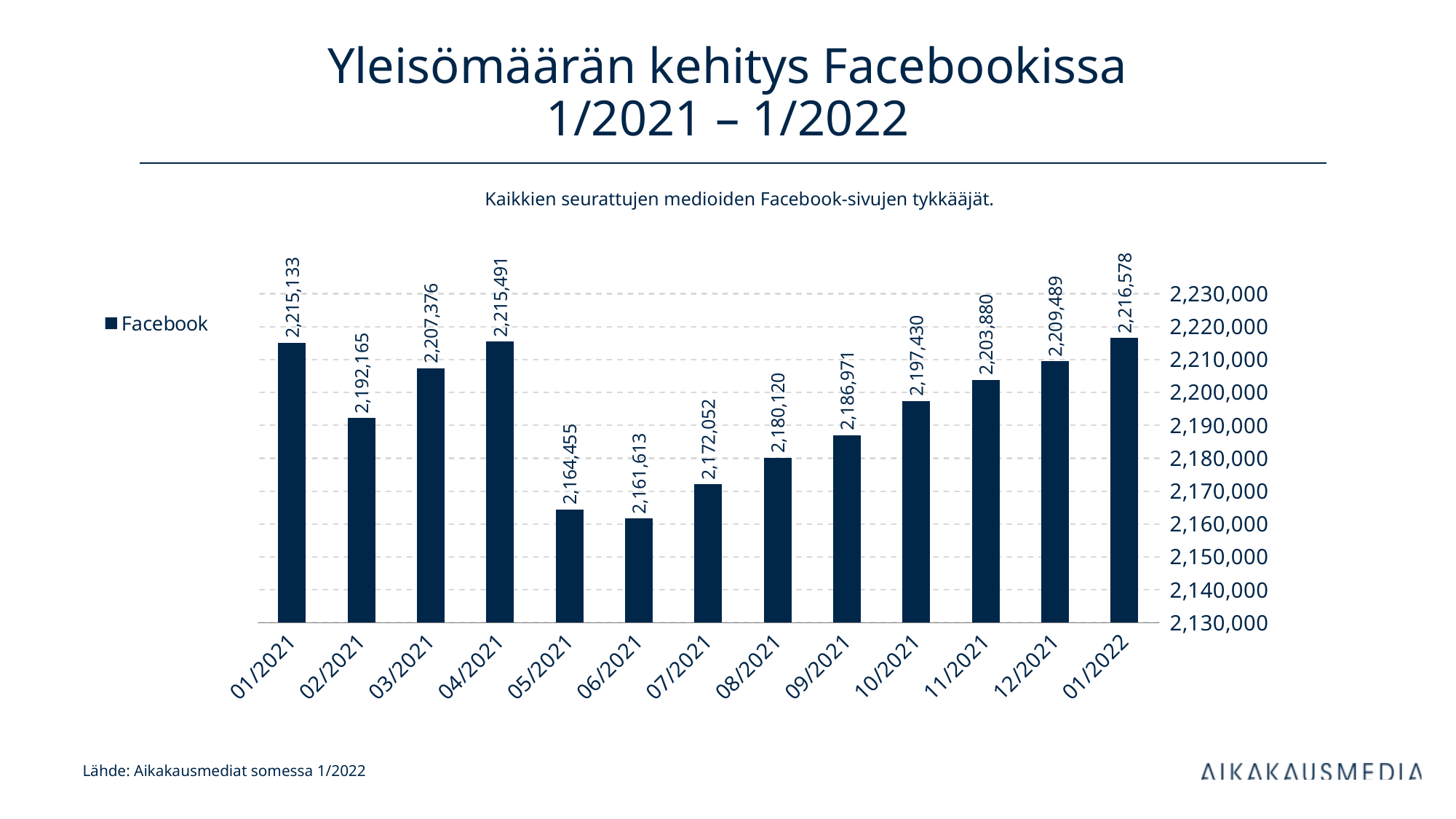
What is the difference between the values for 04/2021 and 05/2021? 51,036 What is the difference between the values for 01/2022 and 01/2021? 1,445 What is the value for 05/2021? 2,164,455 Do the values rise or fall from 06/2021 to 01/2022? rise What is the value for 01/2022? 2,216,578 Is the value for 08/2021 greater or less than 2,190,000? less How many series does the legend list? 1 What is the value for 10/2021? 2,197,430 Which is larger, the value for 03/2021 or the value for 12/2021? 12/2021 How many months are shown on the x axis? 13 Which month has the highest value? 01/2022 Which month has the lowest value? 06/2021